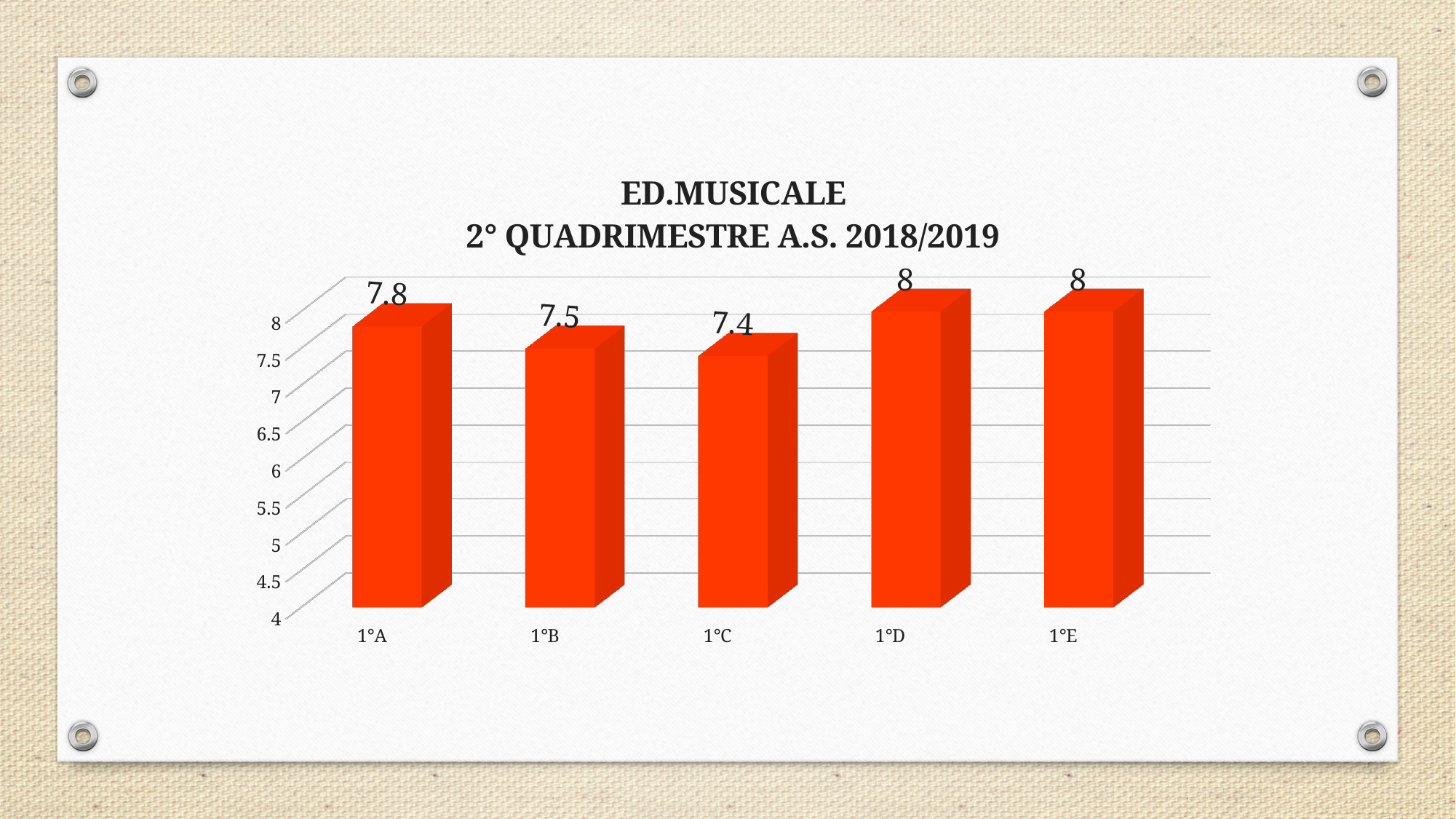
Which is larger, the value for 1°A or the value for 1°B? 1°A What kind of chart is shown on the slide? bar chart How many classes are shown on the chart? 5 What is the value for 1°D? 8 Which class has the lowest value? 1°C What is the value for 1°B? 7.5 What is the value for 1°C? 7.4 What is the title of the chart? ED.MUSICALE 2° QUADRIMESTRE A.S. 2018/2019 What is the value for 1°A? 7.8 What is the difference between the values for 1°A and 1°C? 0.4 Is the value for 1°C greater or less than 7? greater What is the difference between the values for 1°D and 1°B? 0.5